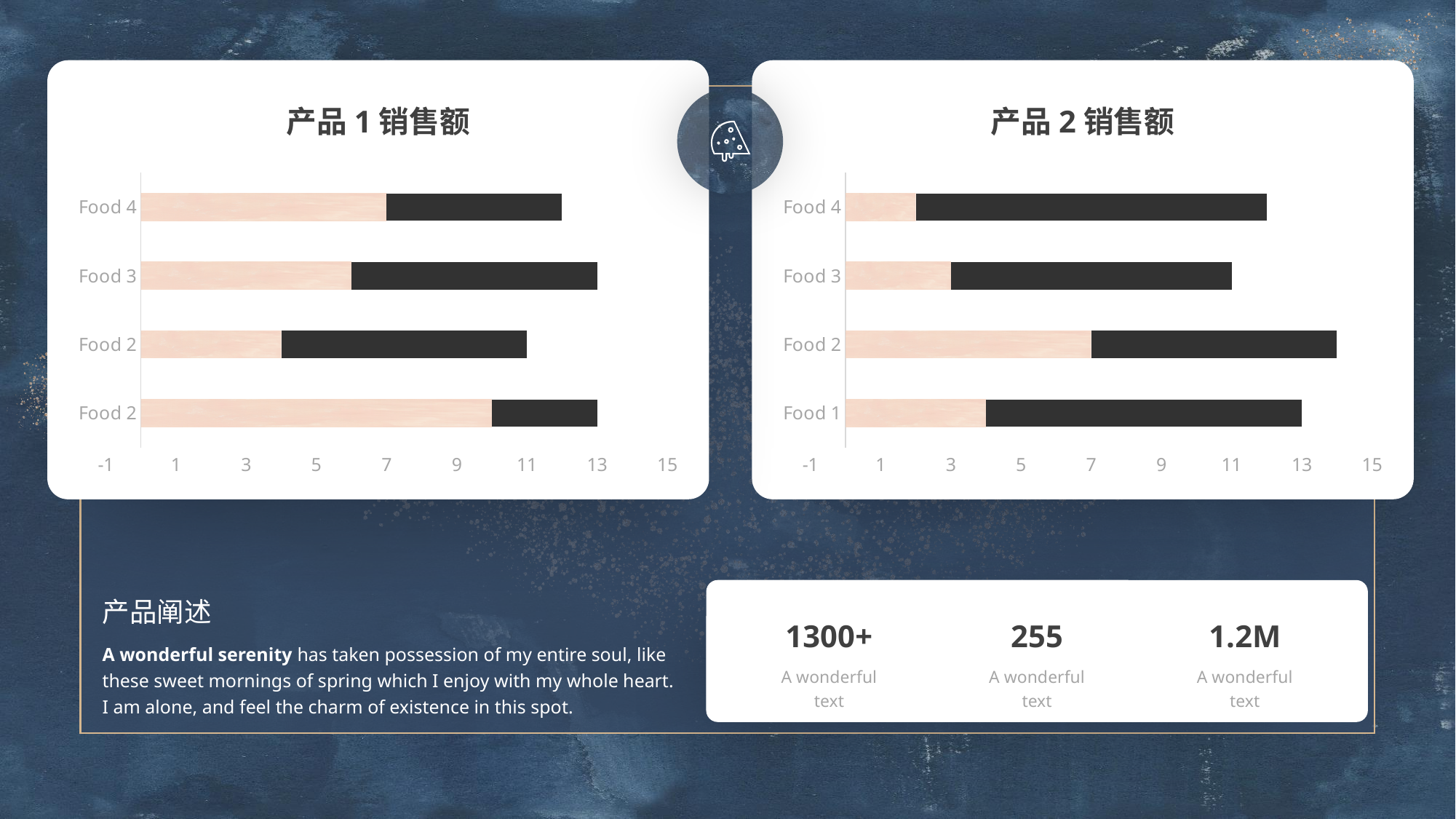
In the 产品 2 销售额 chart, is the total bar length for Food 3 greater or less than 13? less In the 产品 2 销售额 chart, is the total bar length for Food 2 greater or less than 13? greater In the 产品 1 销售额 chart, is the total bar length for Food 3 greater or less than 11? greater In the 产品 2 销售额 chart, which has the longer light-coloured segment, Food 2 or Food 3? Food 2 What is the title of the chart on the left? 产品 1 销售额 In the 产品 2 销售额 chart, which has the longer total bar, Food 2 or Food 4? Food 2 In the 产品 1 销售额 chart, which has the longer light-coloured segment, Food 4 or Food 3? Food 4 How many categories are shown on the 产品 2 销售额 chart? 4 How many charts are shown on the slide? 2 What kind of chart is the 产品 1 销售额 chart? bar chart